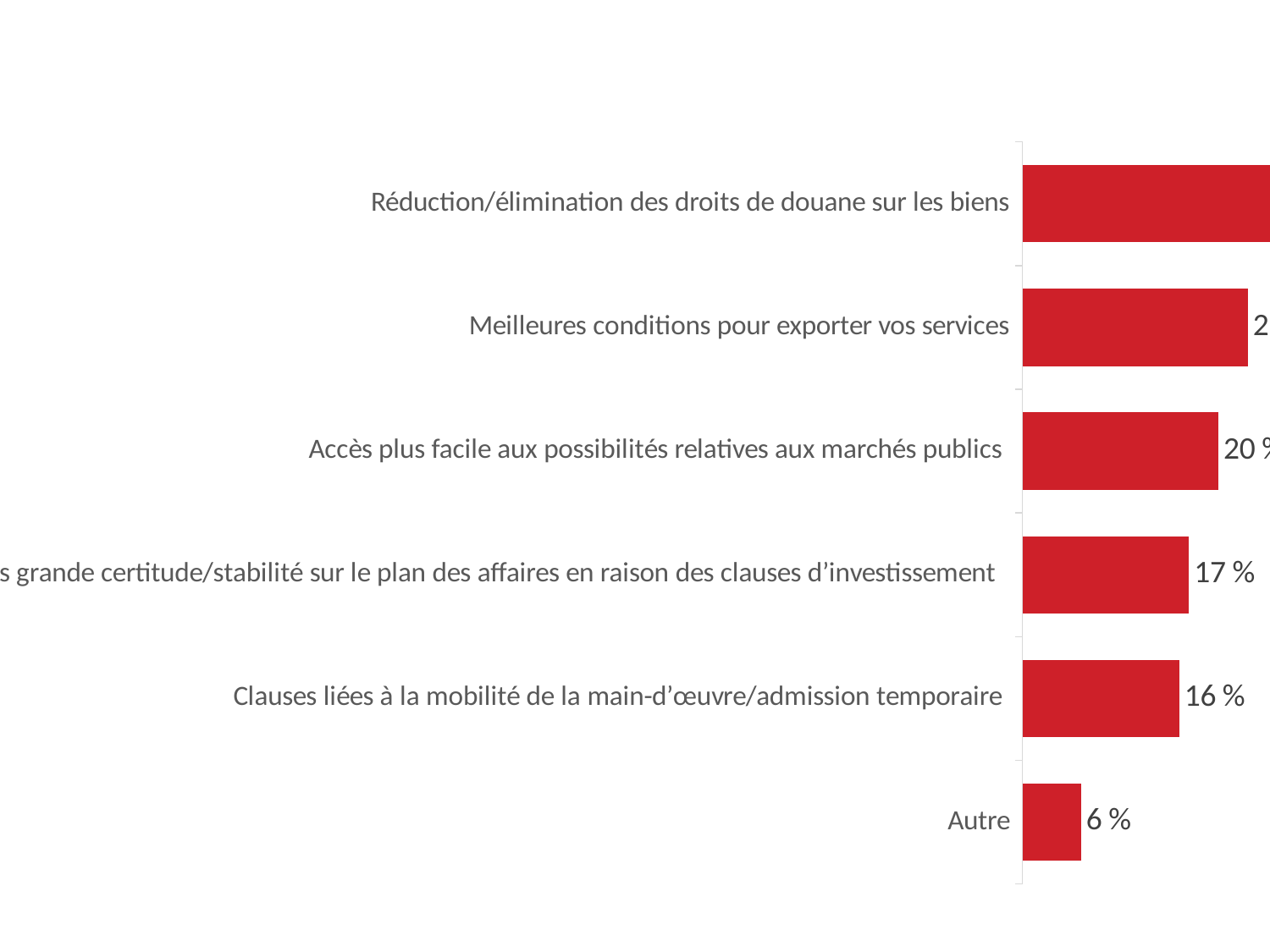
What is the value shown on the fourth bar from the top (the one about clauses d’investissement)? 17 % Which category has the lowest value? Autre What kind of chart is shown on the slide? Bar chart Which is larger: the value for "Accès plus facile aux possibilités relatives aux marchés publics" or the value for "Clauses liées à la mobilité de la main-d’œuvre/admission temporaire"? Accès plus facile aux possibilités relatives aux marchés publics What is the value for "Clauses liées à la mobilité de la main-d’œuvre/admission temporaire"? 16 % What is the value for "Autre"? 6 % How many categories (bars) does the chart show? 6 What is the difference between the fourth bar from the top (17 %) and "Clauses liées à la mobilité de la main-d’œuvre/admission temporaire"? 1 % Which category has the longest bar? Réduction/élimination des droits de douane sur les biens What colour are the bars in the chart? Red What is the difference between the value for "Clauses liées à la mobilité de la main-d’œuvre/admission temporaire" and the value for "Autre"? 10 % Which is larger: the value for "Autre" or the value for "Meilleures conditions pour exporter vos services"? Meilleures conditions pour exporter vos services